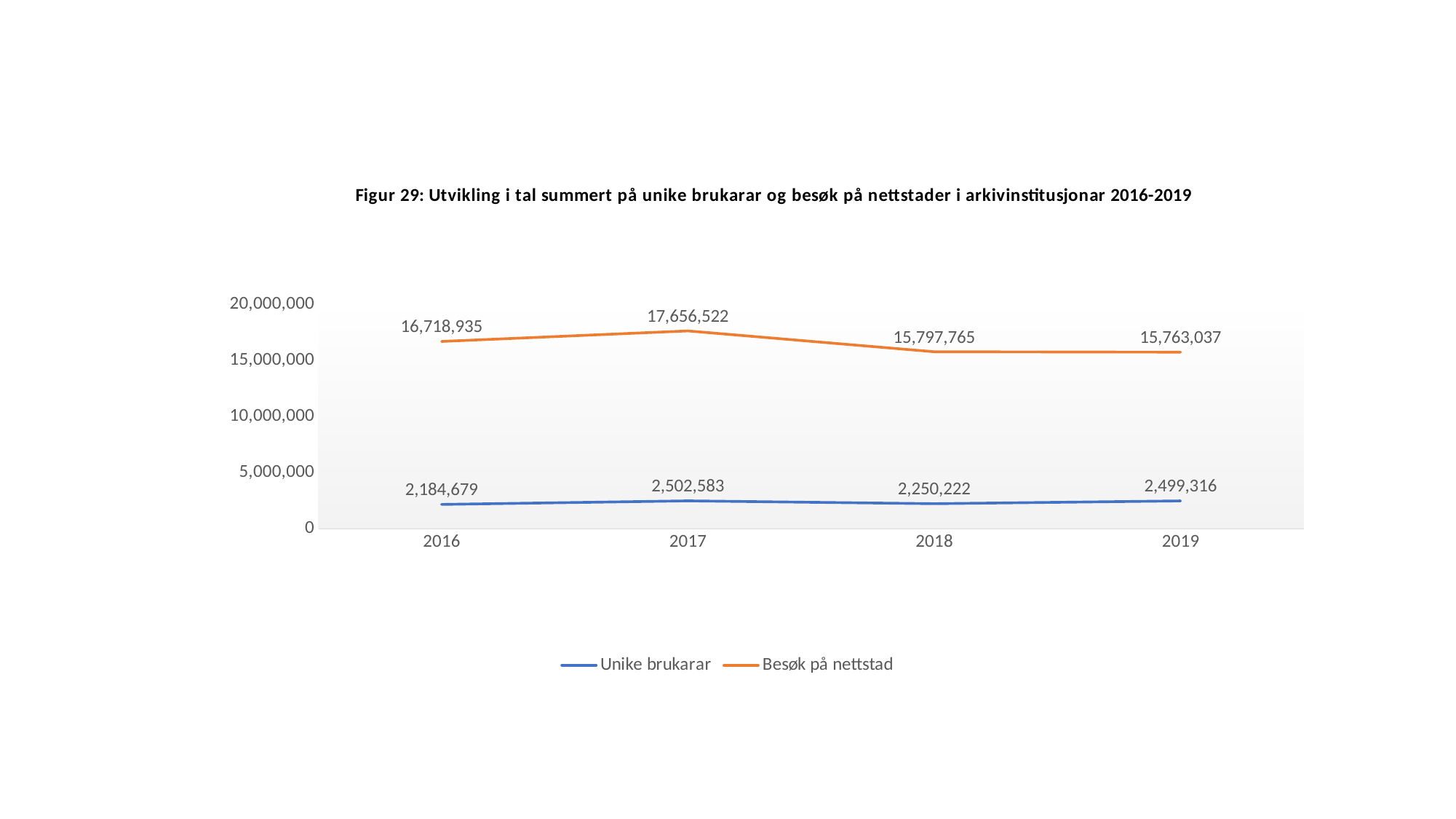
Which is larger: Besøk på nettstad in 2018 or in 2019? 2018 What is the value for Unike brukarar in 2016? 2,184,679 In which year is Unike brukarar lowest? 2016 What is the difference between Unike brukarar in 2019 and 2018? 249,094 How many series does the legend list? 2 What is the value for Unike brukarar in 2019? 2,499,316 Is the value for Besøk på nettstad in 2016 greater or less than 15,000,000? greater In which year is Besøk på nettstad highest? 2017 What is the value for Besøk på nettstad in 2017? 17,656,522 How many years are shown on the x axis? 4 What kind of chart is shown on the slide? Line chart What is the difference between Besøk på nettstad in 2017 and 2016? 937,587